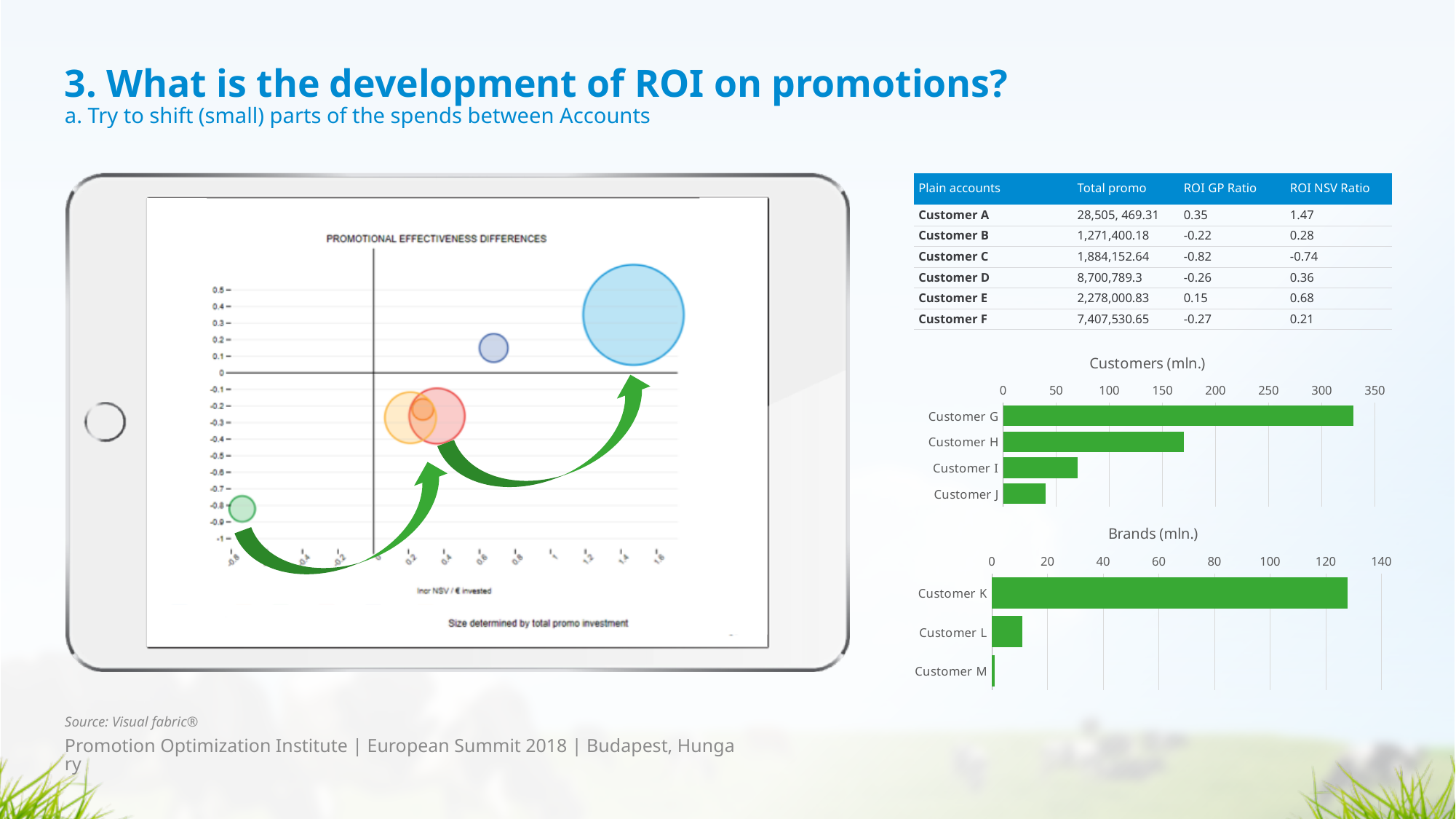
In the Customers (mln.) chart, is the value for Customer G greater or less than 300? greater What type of chart is the Brands (mln.) chart? bar chart In the Brands (mln.) chart, is the value for Customer K greater or less than 120? greater In the Brands (mln.) chart, which customer has the highest value? Customer K In the Customers (mln.) chart, is the value for Customer I greater or less than 50? greater How many customers are shown in the Customers (mln.) chart? 4 In the Customers (mln.) chart, which customer has the lowest value? Customer J In the Brands (mln.) chart, which customer has the lowest value? Customer M In the Customers (mln.) chart, which is larger, the value for Customer H or Customer I? Customer H In the Customers (mln.) chart, which customer has the highest value? Customer G